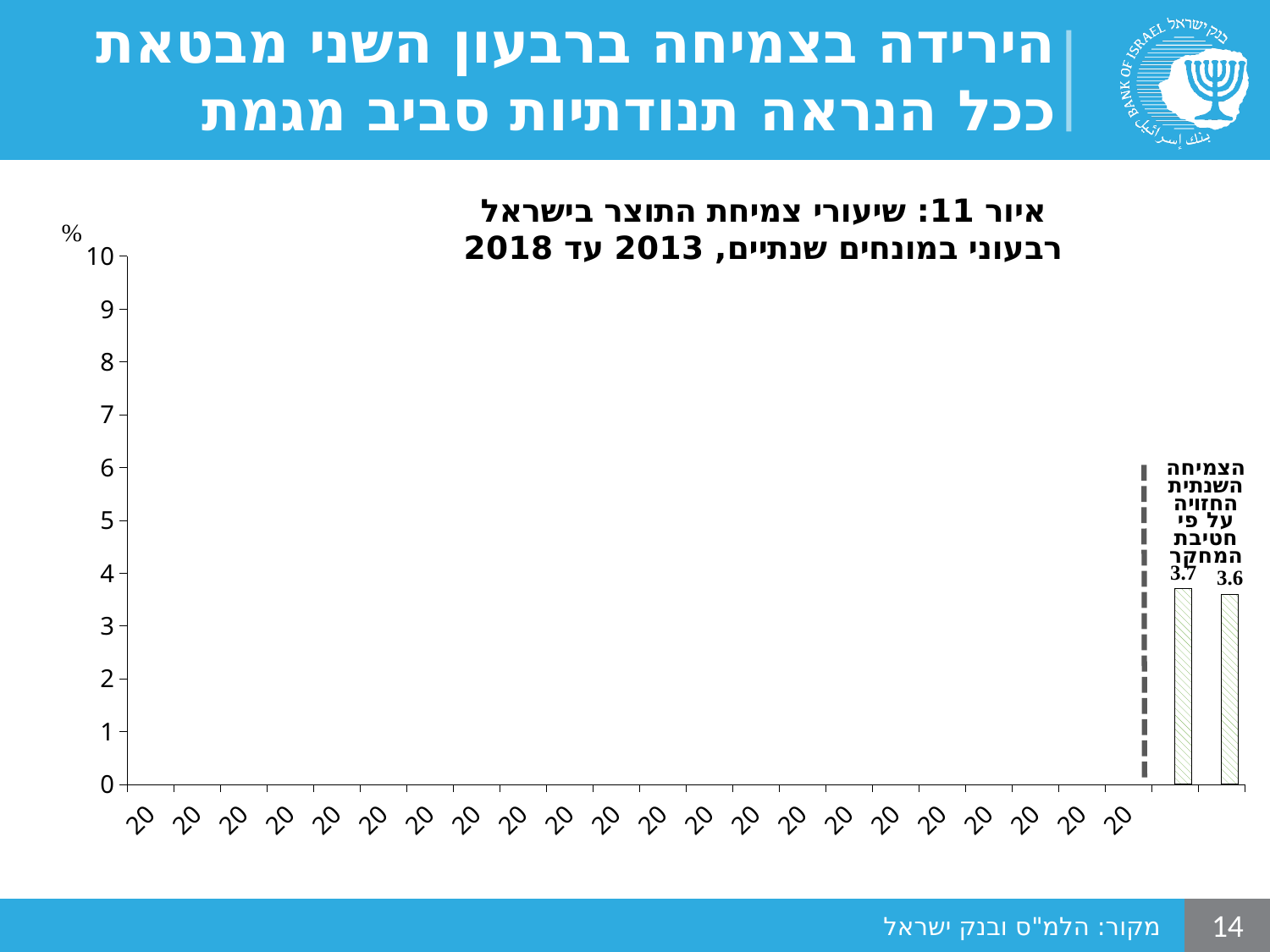
What is the highest value shown on the vertical axis of the chart? 10 What is the difference between the two labelled bar values, 3.7 and 3.6? 0.1 Is the value of the bar labelled 3.7 greater or less than 3? greater What unit is indicated at the top of the vertical axis? % What value is printed on the rightmost bar of the chart? 3.6 Is the value of the rightmost bar greater or less than 4? less What value is printed on the bar immediately to the left of the rightmost bar (the bar next to the dashed vertical line)? 3.7 What kind of chart is shown on the slide? Bar chart Which of the two labelled bars is taller, the one next to the dashed line or the rightmost one? The one next to the dashed line (3.7) How many bars with printed data labels are visible on the chart? 2